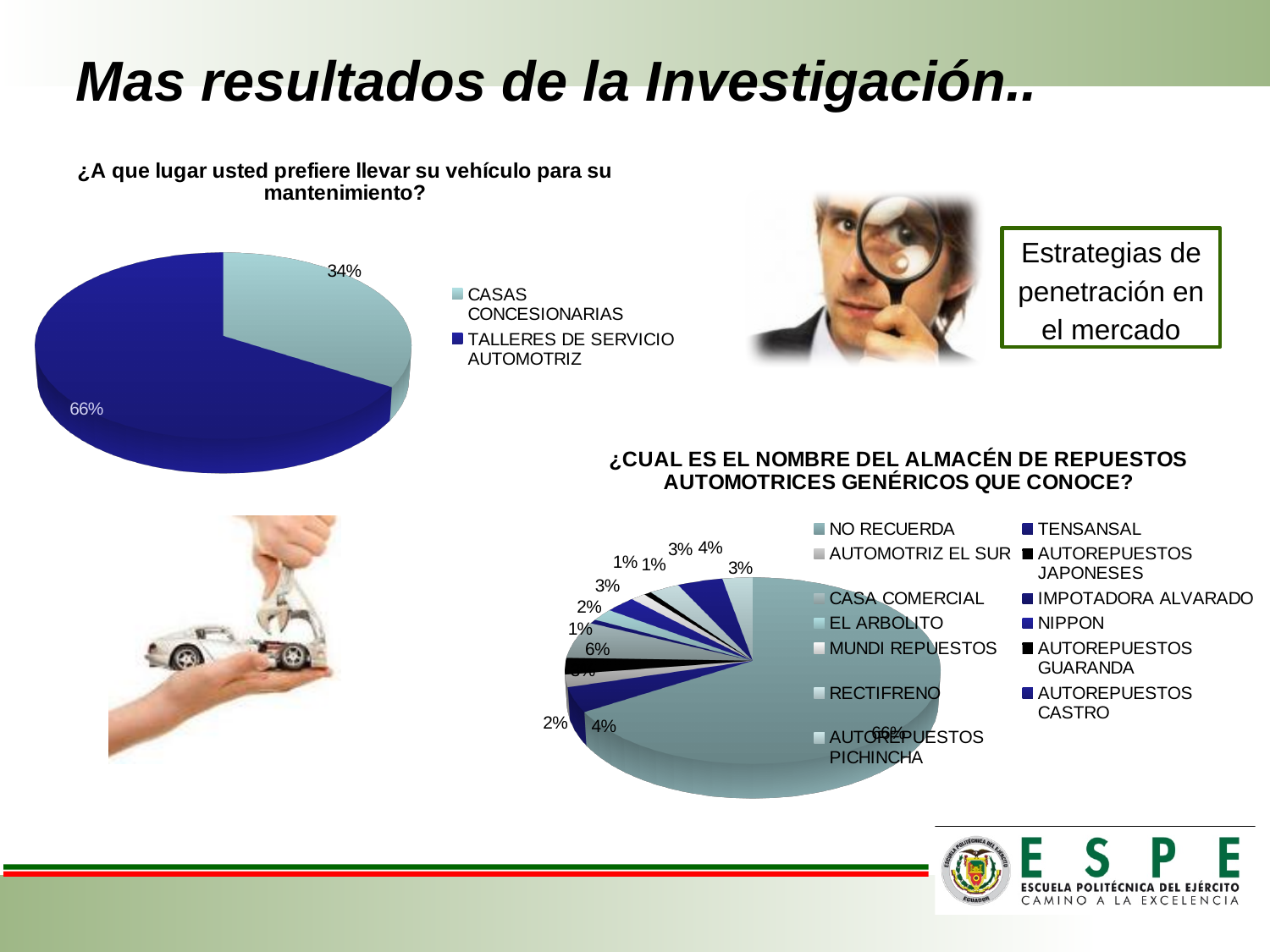
In the pie chart titled "¿CUAL ES EL NOMBRE DEL ALMACÉN DE REPUESTOS AUTOMOTRICES GENÉRICOS QUE CONOCE?", how many entries does the legend list? 13 In the pie chart titled "¿A que lugar usted prefiere llevar su vehículo para su mantenimiento?", which is larger: CASAS CONCESIONARIAS or TALLERES DE SERVICIO AUTOMOTRIZ? TALLERES DE SERVICIO AUTOMOTRIZ In the pie chart titled "¿A que lugar usted prefiere llevar su vehículo para su mantenimiento?", which category has the smallest share? CASAS CONCESIONARIAS What type of chart is used for "¿CUAL ES EL NOMBRE DEL ALMACÉN DE REPUESTOS AUTOMOTRICES GENÉRICOS QUE CONOCE?"? Pie chart In the pie chart titled "¿A que lugar usted prefiere llevar su vehículo para su mantenimiento?", what percentage corresponds to TALLERES DE SERVICIO AUTOMOTRIZ? 66% In the pie chart titled "¿CUAL ES EL NOMBRE DEL ALMACÉN DE REPUESTOS AUTOMOTRICES GENÉRICOS QUE CONOCE?", what is the first entry listed in the legend? NO RECUERDA In the pie chart titled "¿A que lugar usted prefiere llevar su vehículo para su mantenimiento?", which category has the largest share? TALLERES DE SERVICIO AUTOMOTRIZ In the pie chart titled "¿A que lugar usted prefiere llevar su vehículo para su mantenimiento?", how many categories does the legend list? 2 In the pie chart titled "¿A que lugar usted prefiere llevar su vehículo para su mantenimiento?", what percentage corresponds to CASAS CONCESIONARIAS? 34% What type of chart is used for "¿A que lugar usted prefiere llevar su vehículo para su mantenimiento?"? Pie chart In the pie chart titled "¿A que lugar usted prefiere llevar su vehículo para su mantenimiento?", by how many percentage points does TALLERES DE SERVICIO AUTOMOTRIZ exceed CASAS CONCESIONARIAS? 32 percentage points In the pie chart titled "¿CUAL ES EL NOMBRE DEL ALMACÉN DE REPUESTOS AUTOMOTRICES GENÉRICOS QUE CONOCE?", which category has the largest share? NO RECUERDA